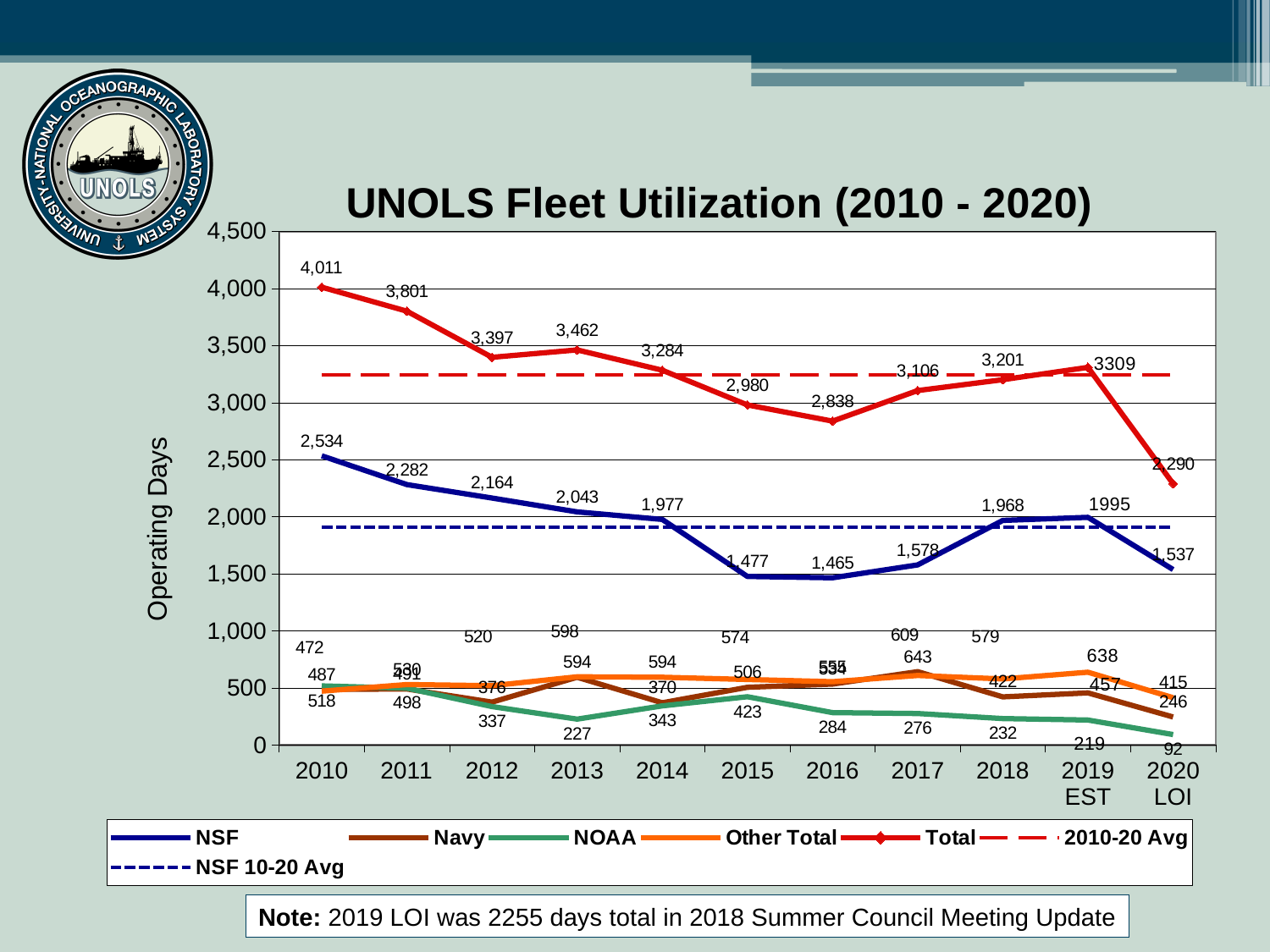
Which is larger, the Total value for 2013 or for 2014? 2013 What was the Total number of operating days in 2016? 2,838 What was the NSF value for 2019 EST? 1995 How many series does the legend list? 7 What is the difference between the Total values for 2010 and 2011? 210 In which year was the Total series highest? 2010 Does the NSF series rise or fall from 2010 to 2014? fall In which year was the Total series lowest? 2020 LOI What was the NSF value in 2010? 2,534 What was the Total number of operating days in 2010? 4,011 Is the NSF value for 2016 greater or less than 2,000? less What kind of chart is shown on the slide? line chart